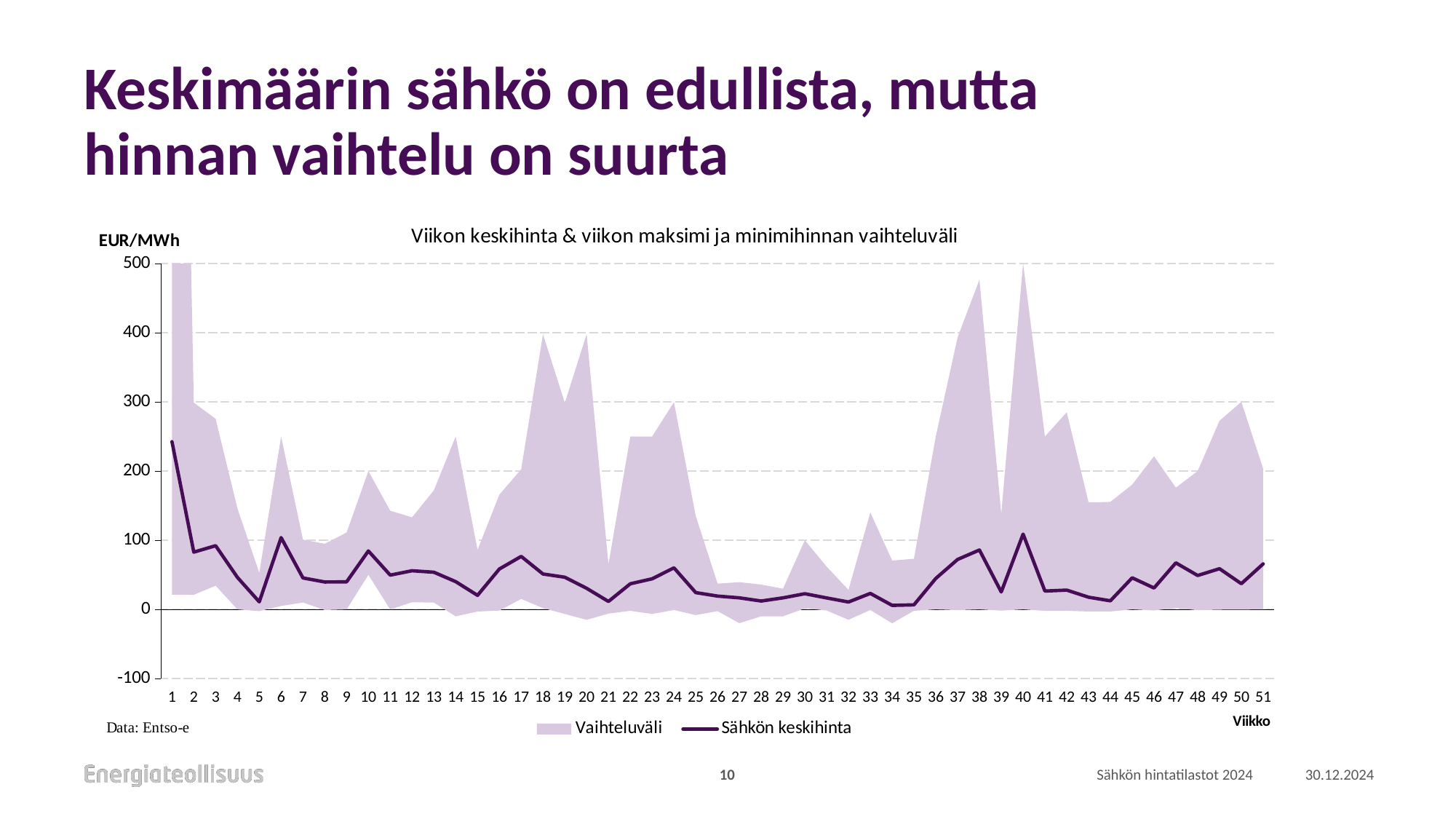
Is the Sähkön keskihinta value for week 17 greater or less than 100? less Which week has the larger Sähkön keskihinta value, week 17 or week 30? week 17 What is the title of the chart? Viikon keskihinta & viikon maksimi ja minimihinnan vaihteluväli How many series does the chart legend list? 2 Is the Sähkön keskihinta value for week 30 greater or less than 100? less In which week is the Sähkön keskihinta line at its highest? 1 How many weeks are plotted along the x axis? 51 What unit is shown on the y axis of the chart? EUR/MWh Is the Sähkön keskihinta value for week 1 greater or less than 200? greater Does the Sähkön keskihinta line rise or fall from week 1 to week 5? fall Which week has the larger Sähkön keskihinta value, week 1 or week 40? week 1 What kind of chart is shown on the slide? combination area and line chart